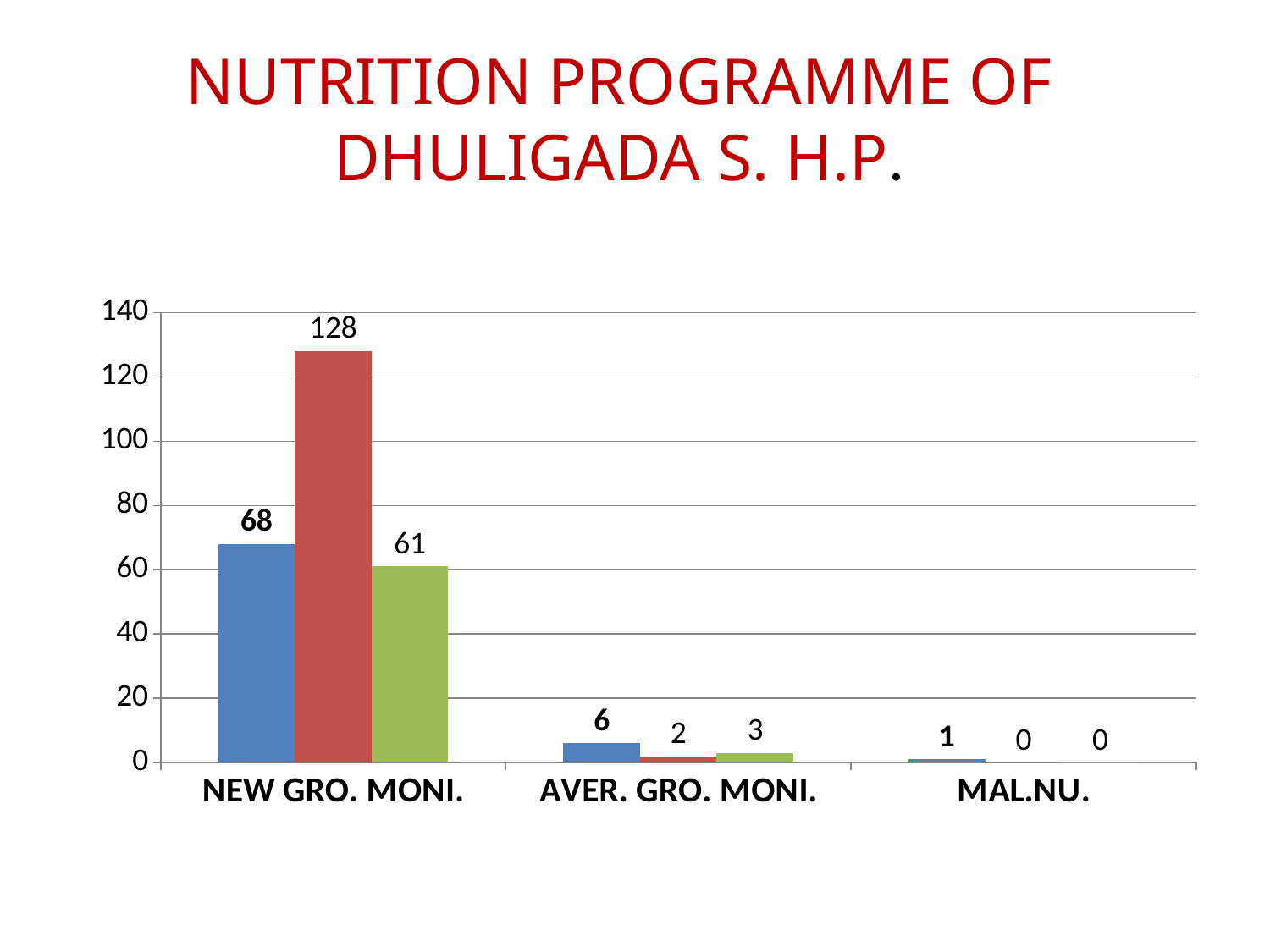
Which category has the highest red bar? NEW GRO. MONI. What is the value of the blue bar for NEW GRO. MONI.? 68 What is the value of the red bar for NEW GRO. MONI.? 128 What is the value of the green bar for AVER. GRO. MONI.? 3 What is the title of the slide containing the chart? NUTRITION PROGRAMME OF DHULIGADA S. H.P. What kind of chart is shown on the slide? bar chart Which category has the lowest blue bar? MAL.NU. What is the value of the blue bar for MAL.NU.? 1 What is the difference between the red bar and the green bar for NEW GRO. MONI.? 67 How many categories are shown on the x axis of the chart? 3 For AVER. GRO. MONI., which is larger, the blue bar or the red bar? the blue bar Is the value of the red bar for NEW GRO. MONI. greater or less than 120? greater